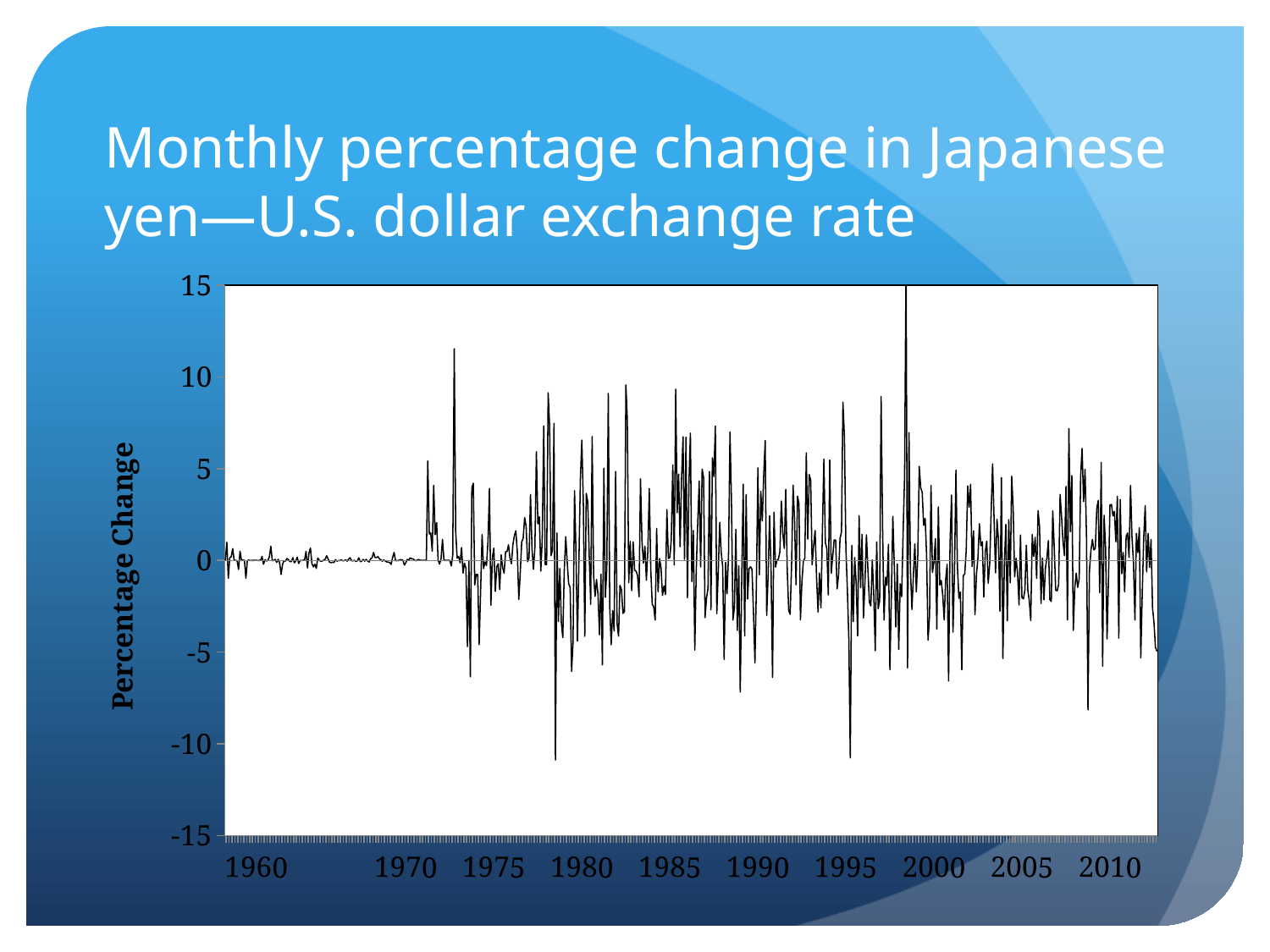
What is the range of the vertical axis? -15 to 15 Is the highest value reached by the line greater or less than 10? greater What kind of chart is shown on the slide? line chart What is the label on the vertical axis of the chart? Percentage Change How many year labels are shown on the horizontal axis? 10 How many tick labels are shown on the vertical axis? 7 Before 1970, are the values of the line greater or less than 5? less Is the line more volatile before or after 1970? after What is the title of the chart on the slide? Monthly percentage change in Japanese yen—U.S. dollar exchange rate Is the spike in the line just before 1975 greater or less than 10? greater